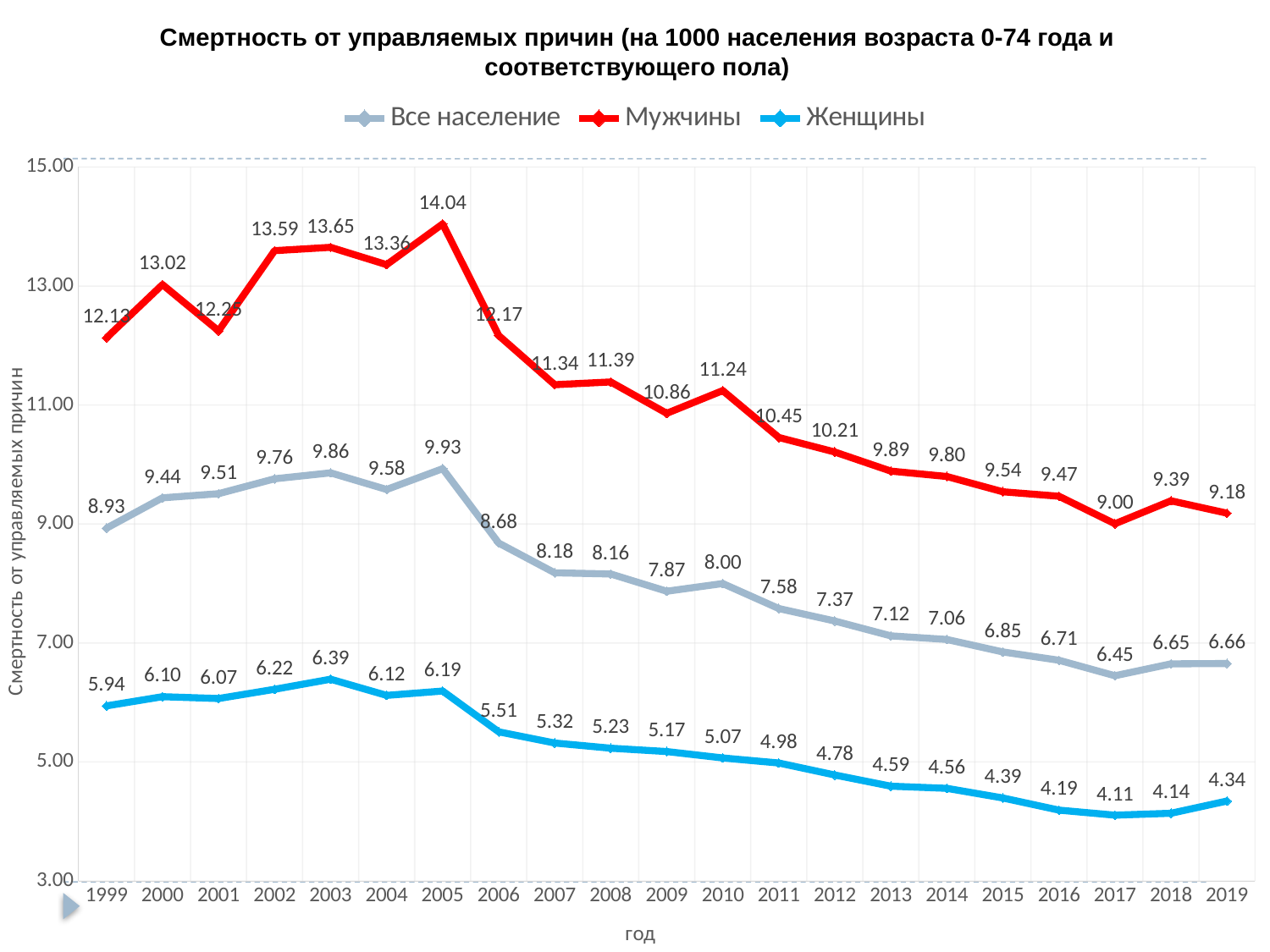
What is the value for Все население in 2010? 8.00 In which year does the Мужчины series reach its highest value? 2005 Which is larger: the Все население value in 2003 or in 2005? 2005 What is the value for Женщины in 2019? 4.34 How many series does the legend list? 3 What is the difference between the Мужчины and Женщины values in 2019? 4.84 What type of chart is shown on the slide? line chart In which year does the Женщины series reach its lowest value? 2017 How many years are plotted along the x axis? 21 What is the value for Мужчины in 2005? 14.04 Does the Все население series generally rise or fall from 2005 to 2019? fall What colour is the line for Мужчины? red